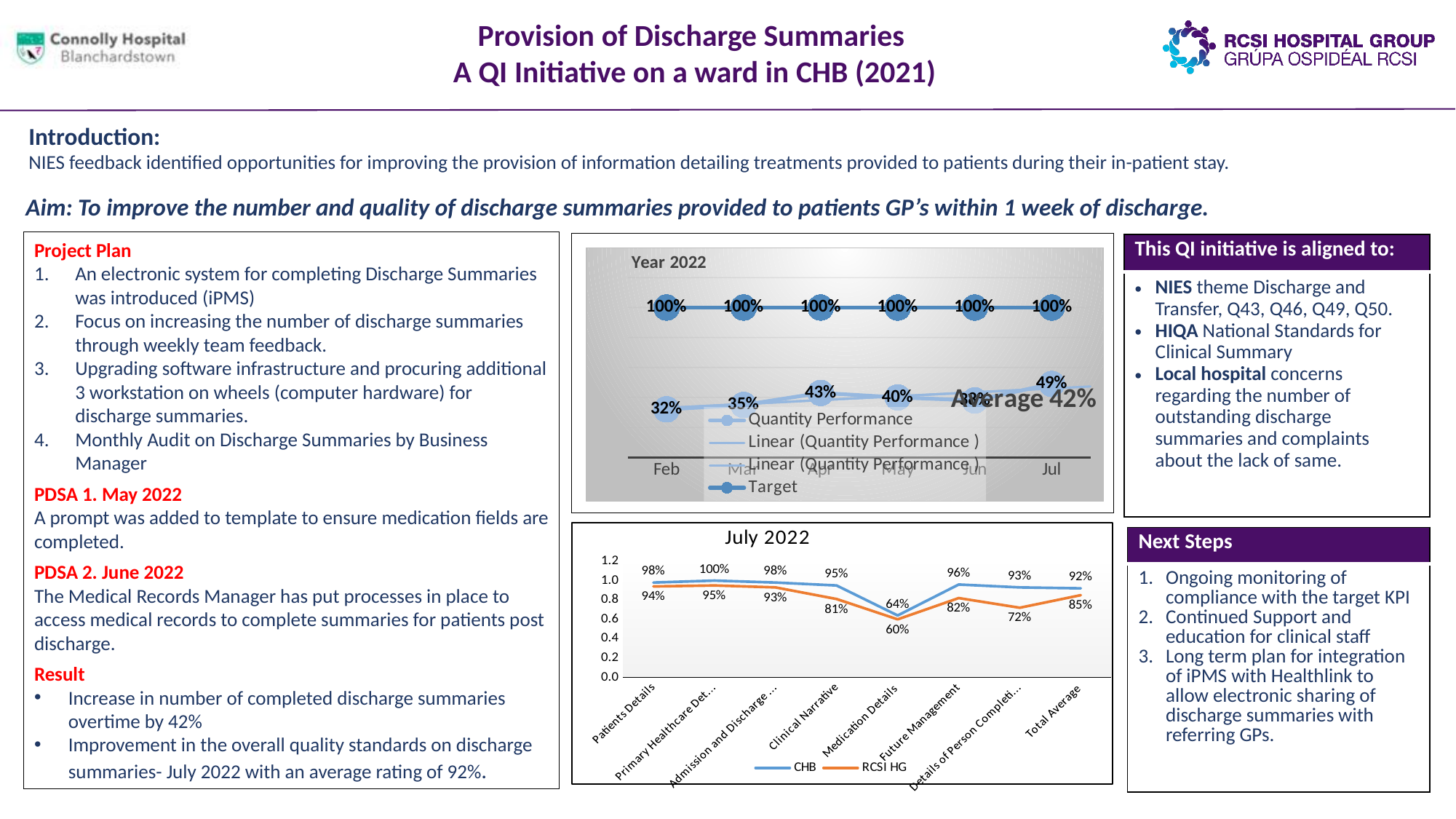
In the 'July 2022' chart, how many series does the legend list? 2 In the 'Year 2022' chart, what is the Quantity Performance value for Feb? 32% In the 'Year 2022' chart, which month has the lowest Quantity Performance? Feb In the 'Year 2022' chart, how many months are plotted on the x axis? 6 In the 'July 2022' chart, what is the RCSI HG value for Total Average? 85% In the 'Year 2022' chart, which month has the highest Quantity Performance? Jul In the 'Year 2022' chart, what is the difference between the Quantity Performance for Apr and for Feb? 11% In the 'July 2022' chart, which category has the lowest RCSI HG value? Medication Details In the 'July 2022' chart, what is the CHB value for Medication Details? 64% In the 'Year 2022' chart, what is the Quantity Performance value for Jul? 49% In the 'July 2022' chart, which is larger for Clinical Narrative: CHB or RCSI HG? CHB In the 'Year 2022' chart, what is the Target value shown for each month? 100%